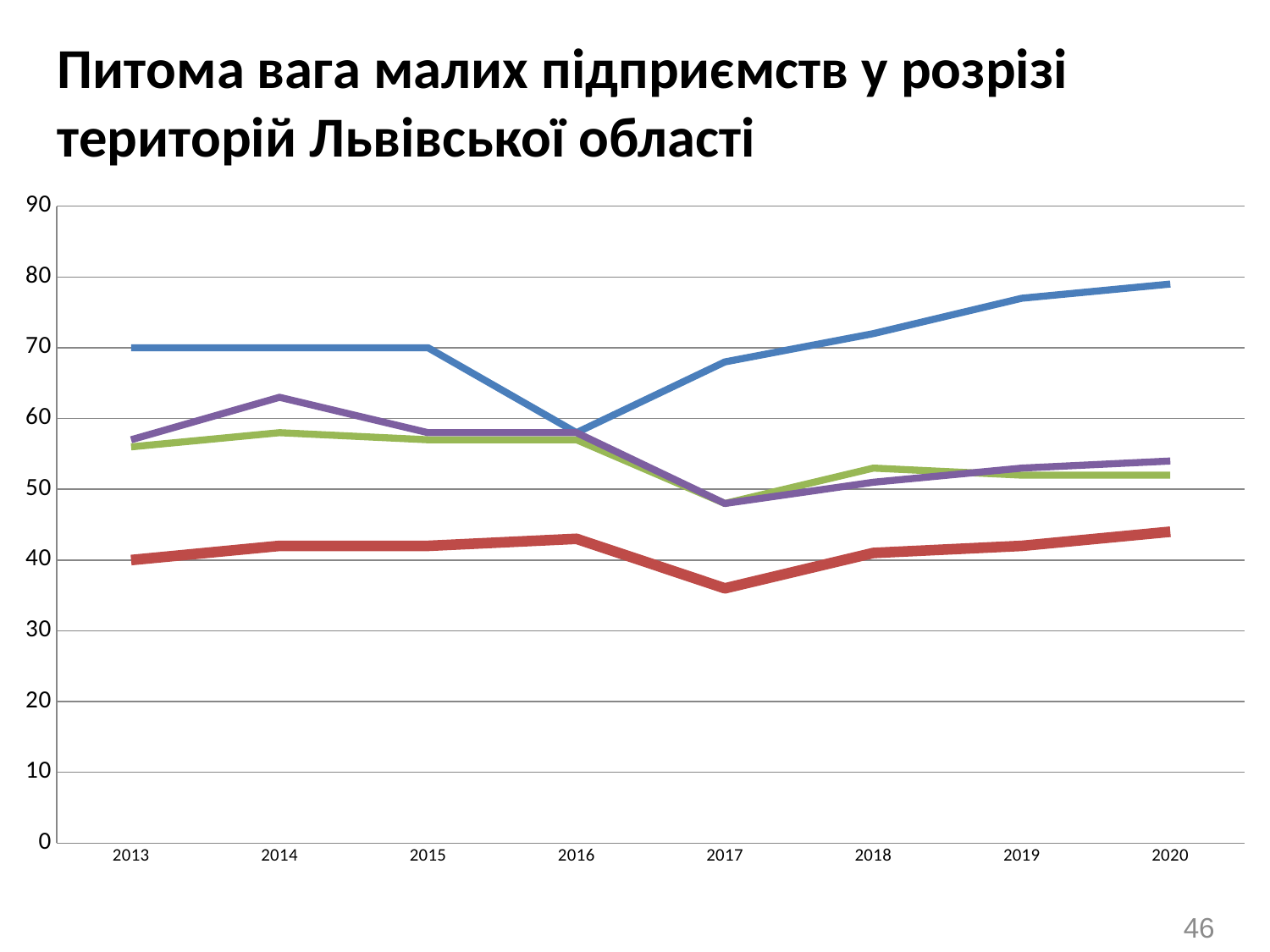
In which year does the purple line reach its highest value? 2014 In which year does the blue line reach its lowest value? 2016 In which year does the red line reach its lowest value? 2017 Is the value of the blue line in 2020 greater or less than 70? greater Is the value of the purple line in 2017 greater or less than 50? less Does the blue line rise or fall from 2016 to 2020? rise What is the title of the chart on the slide? Питома вага малих підприємств у розрізі територій Львівської області How many years are shown on the x axis of the chart? 8 How many lines are plotted on the chart? 4 What kind of chart is shown on the slide? line chart Is the value of the blue line in 2016 greater or less than 60? less